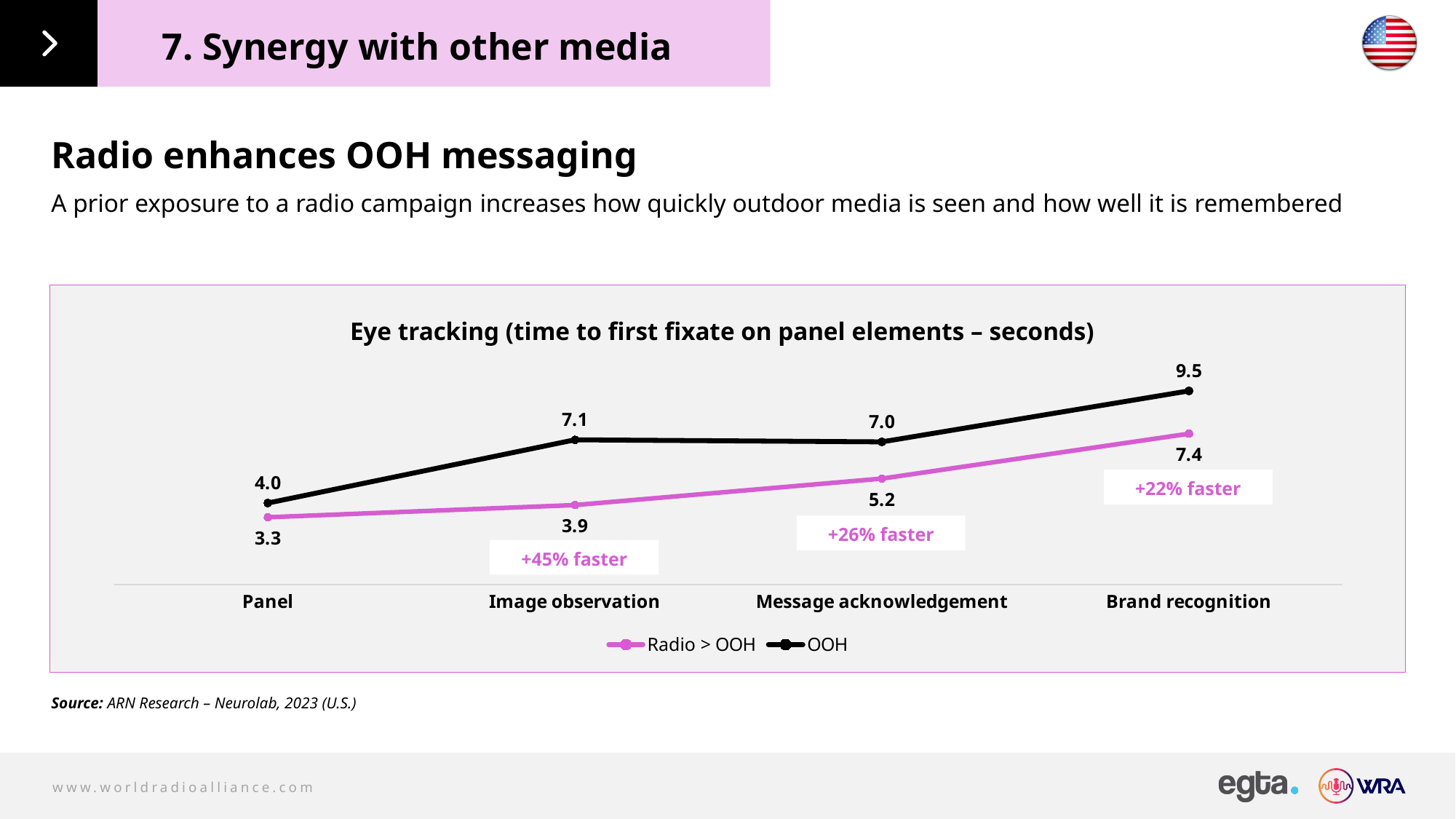
What kind of chart is shown? Line chart Which is larger for Brand recognition, the OOH value or the Radio > OOH value? OOH What is the Radio > OOH value for Message acknowledgement? 5.2 What is the Radio > OOH value for Panel? 3.3 Which category has the highest OOH value? Brand recognition How many series does the legend list? 2 What is the title of the chart? Eye tracking (time to first fixate on panel elements – seconds) How many categories are shown on the x axis? 4 Which category has the lowest Radio > OOH value? Panel What is the OOH value for Brand recognition? 9.5 What is the OOH value for Image observation? 7.1 What is the difference between the OOH and Radio > OOH values for Image observation? 3.2